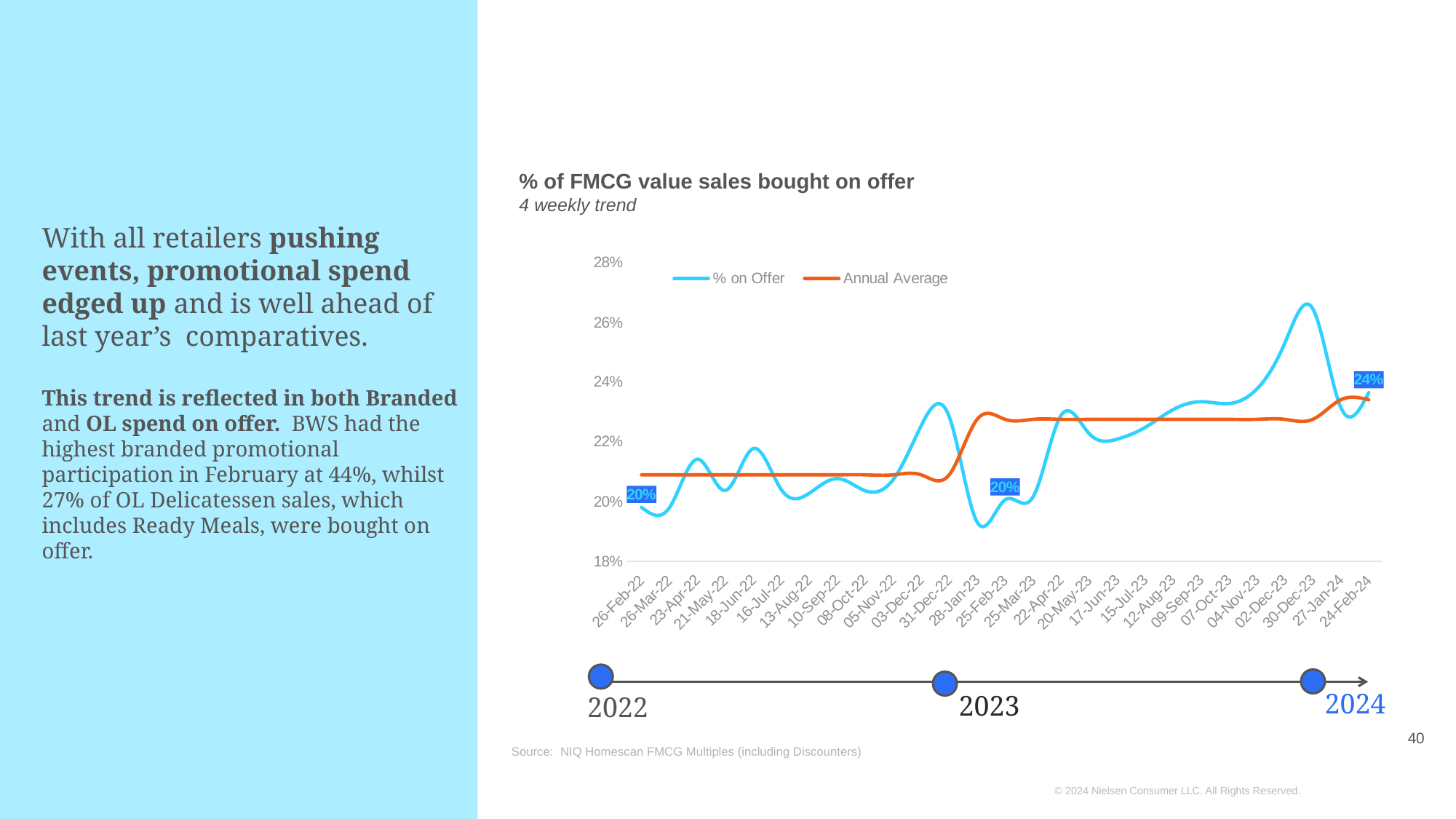
Is the % on Offer value at 30-Dec-23 greater or less than 26%? greater How many dates are shown on the x axis? 27 Is the % on Offer value at 28-Jan-23 greater or less than 20%? less At which date does the % on Offer line reach its highest point? 30-Dec-23 What kind of chart is shown on the slide? line chart How many series does the legend list? 2 By how many percentage points does the labelled % on Offer value at 24-Feb-24 exceed the labelled value at 26-Feb-22? 4 percentage points What is the title of the chart? % of FMCG value sales bought on offer What are the two series named in the legend? % on Offer and Annual Average What is the % on Offer value labelled at 24-Feb-24? 24% What is the % on Offer value labelled at 26-Feb-22? 20% At 30-Dec-23, which is higher: % on Offer or Annual Average? % on Offer